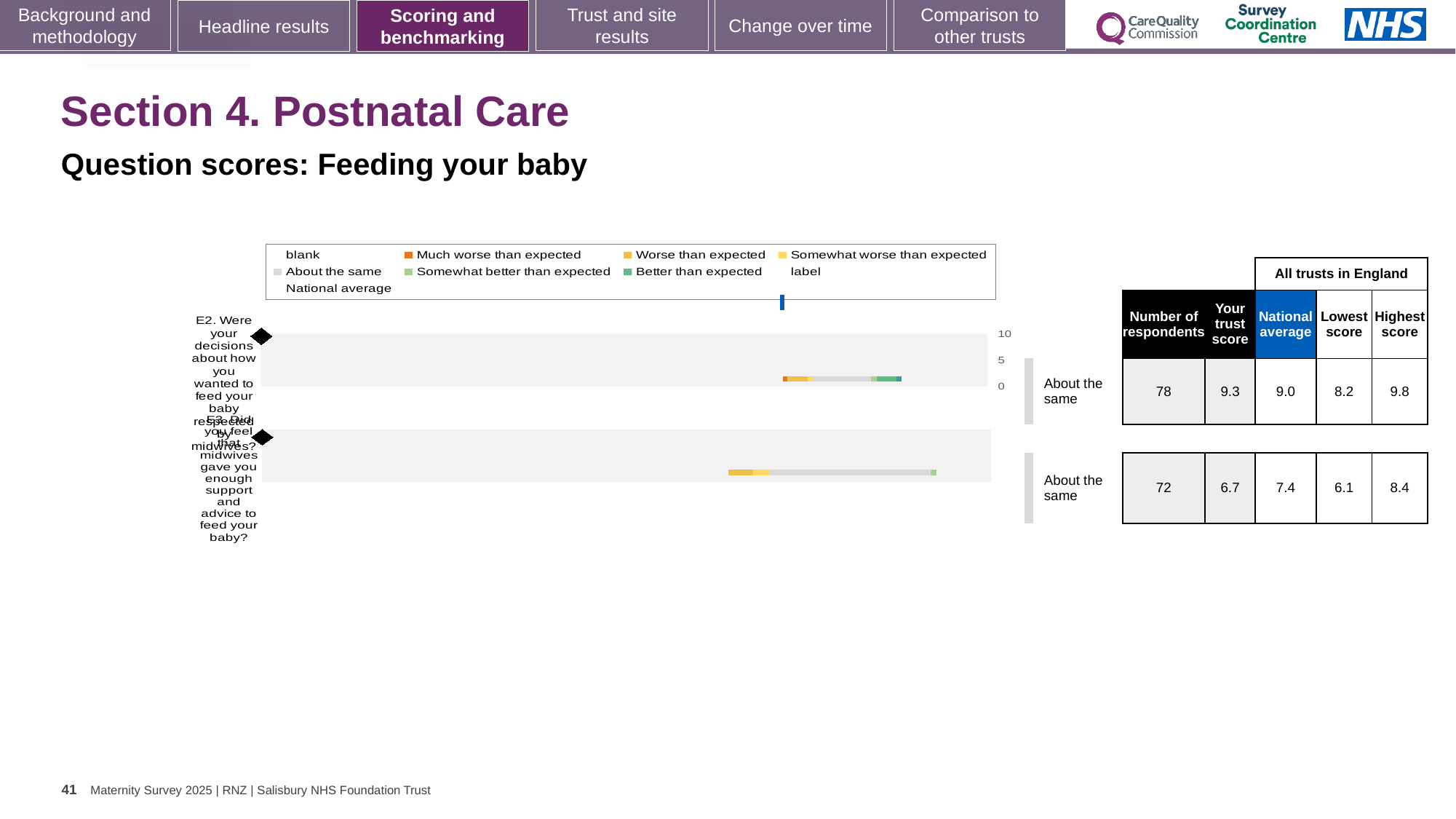
What is the national average for question E2? 9.0 What kind of chart is shown on the slide? bar chart What is the difference between the highest score and the lowest score for question E3? 2.3 What is the number of respondents for question E2 (decisions about how you wanted to feed your baby respected by midwives)? 78 What is the highest score among all trusts in England for question E3? 8.4 What is the difference between the highest score and the lowest score for question E2? 1.6 What colour does the legend use for 'Much worse than expected'? orange What colour does the legend use for 'Better than expected'? green What is the trust score for question E3 (midwives gave you enough support and advice to feed your baby)? 6.7 What benchmark category is shown for question E3? About the same How many questions (categories) are plotted in the chart? 2 Which is larger for question E2: the trust score or the national average? trust score